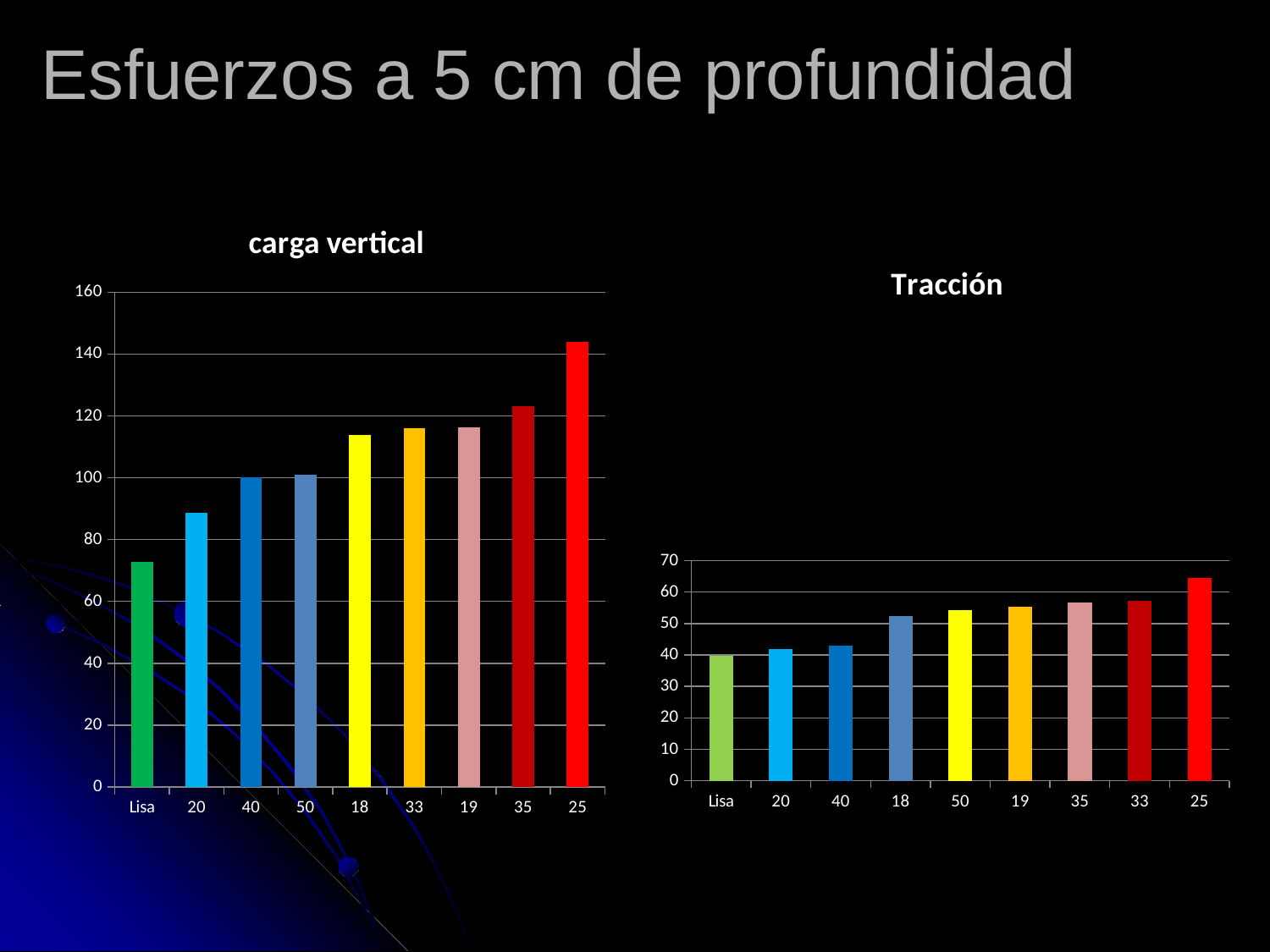
In the "carga vertical" chart, is the value for 35 greater or less than 120? greater In the "carga vertical" chart, which category has the highest value? 25 In the "carga vertical" chart, is the value for Lisa greater or less than 80? less In the "Tracción" chart, do the values generally rise or fall from left to right along the x axis? rise How many categories are shown in the "carga vertical" chart? 9 In the "Tracción" chart, which category has the lowest value? Lisa In the "Tracción" chart, is the value for 25 greater or less than 60? greater What kind of chart is the "carga vertical" chart? bar chart In the "Tracción" chart, which category has the highest value? 25 In the "carga vertical" chart, which category has the lowest value? Lisa